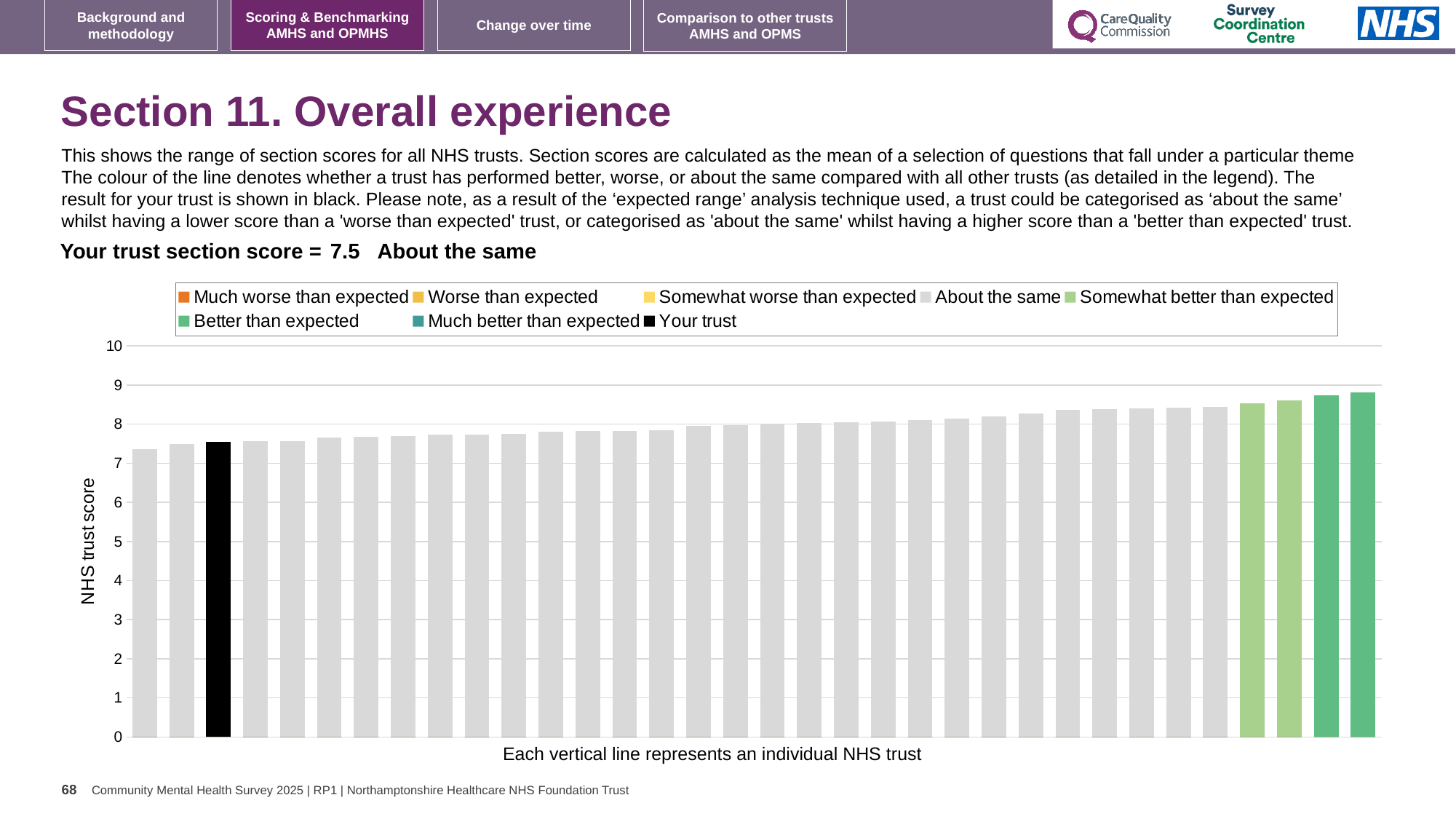
How many entries does the chart legend list? 8 Is the value of the tallest bar greater or less than 9? less Which category is your trust placed in for this section? About the same Is the value for your trust (the black bar) greater or less than 7? greater What is the section score for your trust shown on the slide? 7.5 Do the bar values rise or fall from left to right along the x axis? rise How many bars are coloured as 'Somewhat better than expected' (light green)? 2 Which is larger, the rightmost bar or the black 'Your trust' bar? the rightmost bar Is the value for your trust (the black bar) greater or less than 8? less What kind of chart is shown on the slide? bar chart What is the label on the vertical axis of the chart? NHS trust score